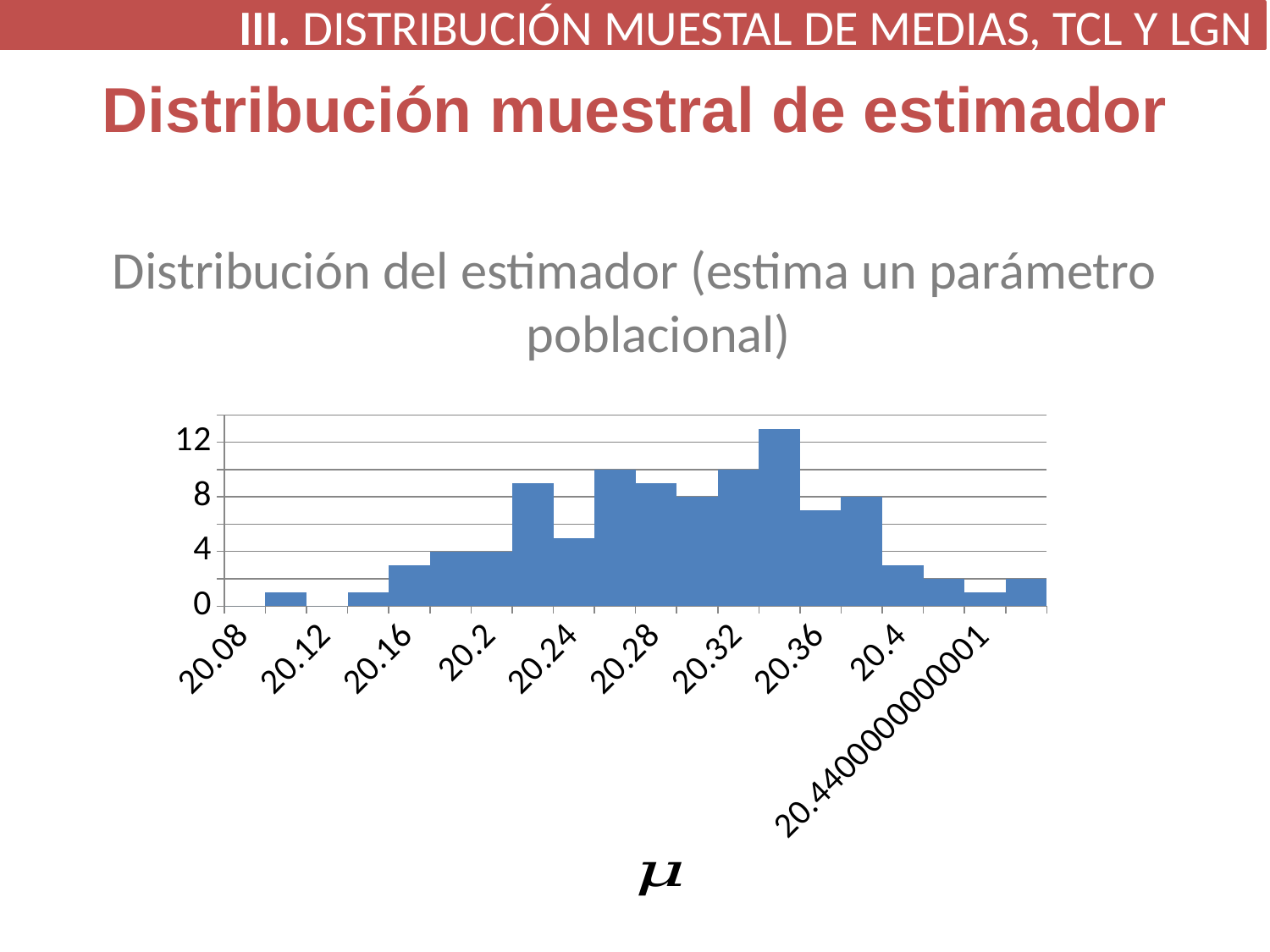
What label is shown on the horizontal axis of the chart? μ Is the value of the bar immediately to the right of the 20.36 tick greater or less than 4? greater What is the title of the chart? Distribución del estimador (estima un parámetro poblacional) What is the smallest labelled value on the horizontal axis of the chart? 20.08 Is the value of the bar immediately to the left of the 20.12 tick greater or less than 4? less Is the value of the bar immediately to the left of the 20.16 tick greater or less than 4? less What kind of chart is shown on the slide? bar chart How many labelled tick values are shown on the horizontal axis of the chart? 10